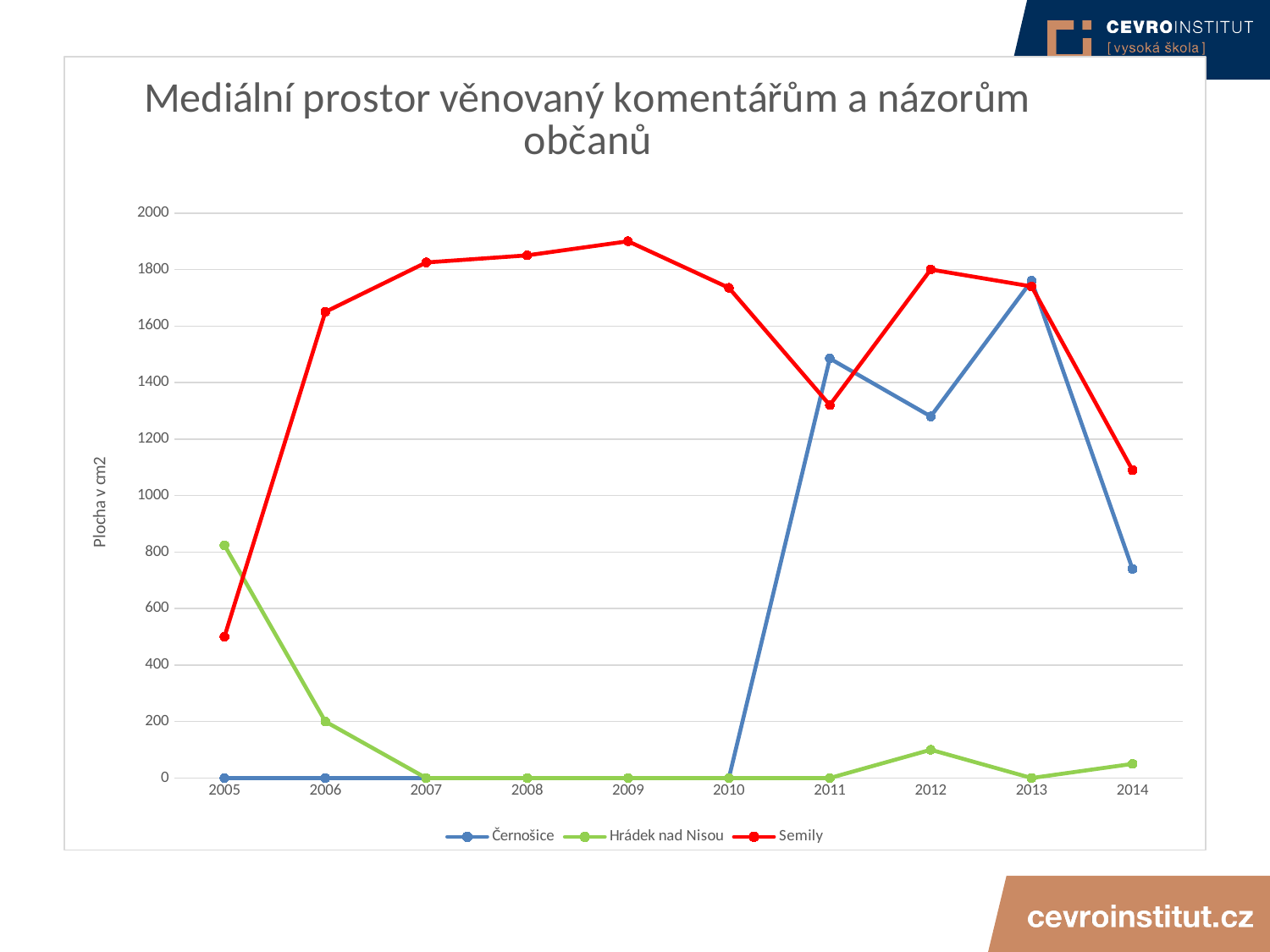
Does the value for Hrádek nad Nisou rise or fall from 2005 to 2007? fall In which year does Hrádek nad Nisou have its highest value? 2005 Is the value for Černošice in 2014 greater or less than 800? less Is the value for Semily in 2014 greater or less than 1000? greater In 2011, which series has the larger value, Černošice or Semily? Černošice What type of chart is shown on the slide? line chart Is the value for Semily in 2005 greater or less than 600? less What is the value for Černošice in 2008? 0 How many years are shown on the x axis? 10 In which year does Semily reach its highest value? 2009 What is the value for Hrádek nad Nisou in 2006? 200 How many series does the legend list? 3